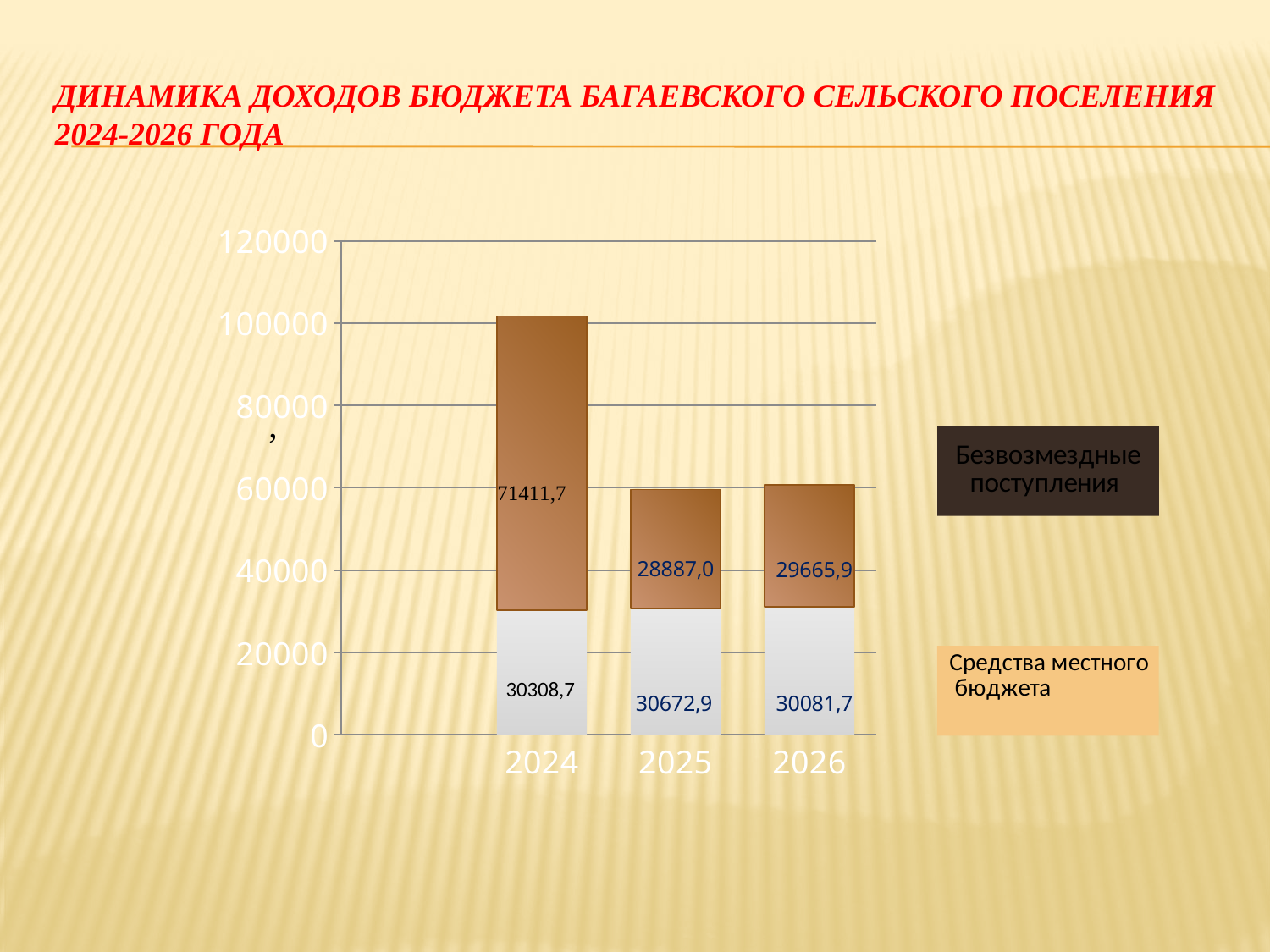
How many years (categories) are shown on the x axis? 3 What type of chart is shown on the slide? bar chart What is the difference between Безвозмездные поступления in 2024 and in 2025? 42524,7 What is the total of the stacked bar for 2024? 101720,4 In which year is Безвозмездные поступления the lowest? 2025 How many series does the legend list? 2 What is the value of Безвозмездные поступления for 2026? 29665,9 Which is larger: Средства местного бюджета in 2025 or Безвозмездные поступления in 2025? Средства местного бюджета in 2025 What is the value of Средства местного бюджета for 2025? 30672,9 In which year is Безвозмездные поступления the highest? 2024 Which series is shown in brown at the top of each bar? Безвозмездные поступления What is the value of Безвозмездные поступления for 2024? 71411,7